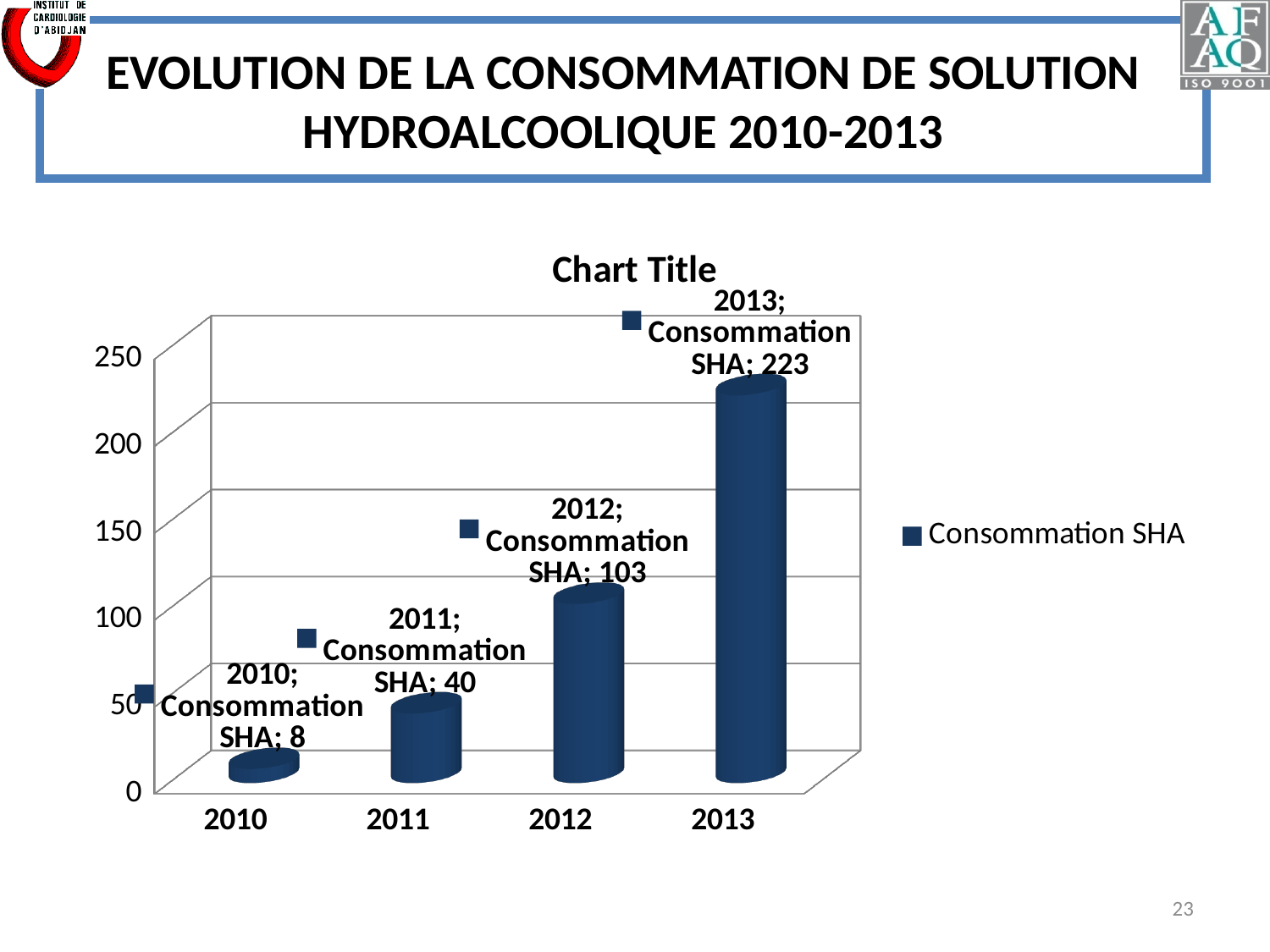
Which year has a larger Consommation SHA, 2011 or 2012? 2012 What is the Consommation SHA value for 2010? 8 How many years are shown on the x axis of the chart? 4 Which year has the lowest Consommation SHA? 2010 What is the Consommation SHA value for 2011? 40 Which year has the highest Consommation SHA? 2013 What is the Consommation SHA value for 2013? 223 What is the difference in Consommation SHA between 2011 and 2010? 32 Does Consommation SHA rise or fall from 2010 to 2013? Rise What is the Consommation SHA value for 2012? 103 What is the difference in Consommation SHA between 2013 and 2012? 120 What kind of chart is shown on the slide? Bar chart